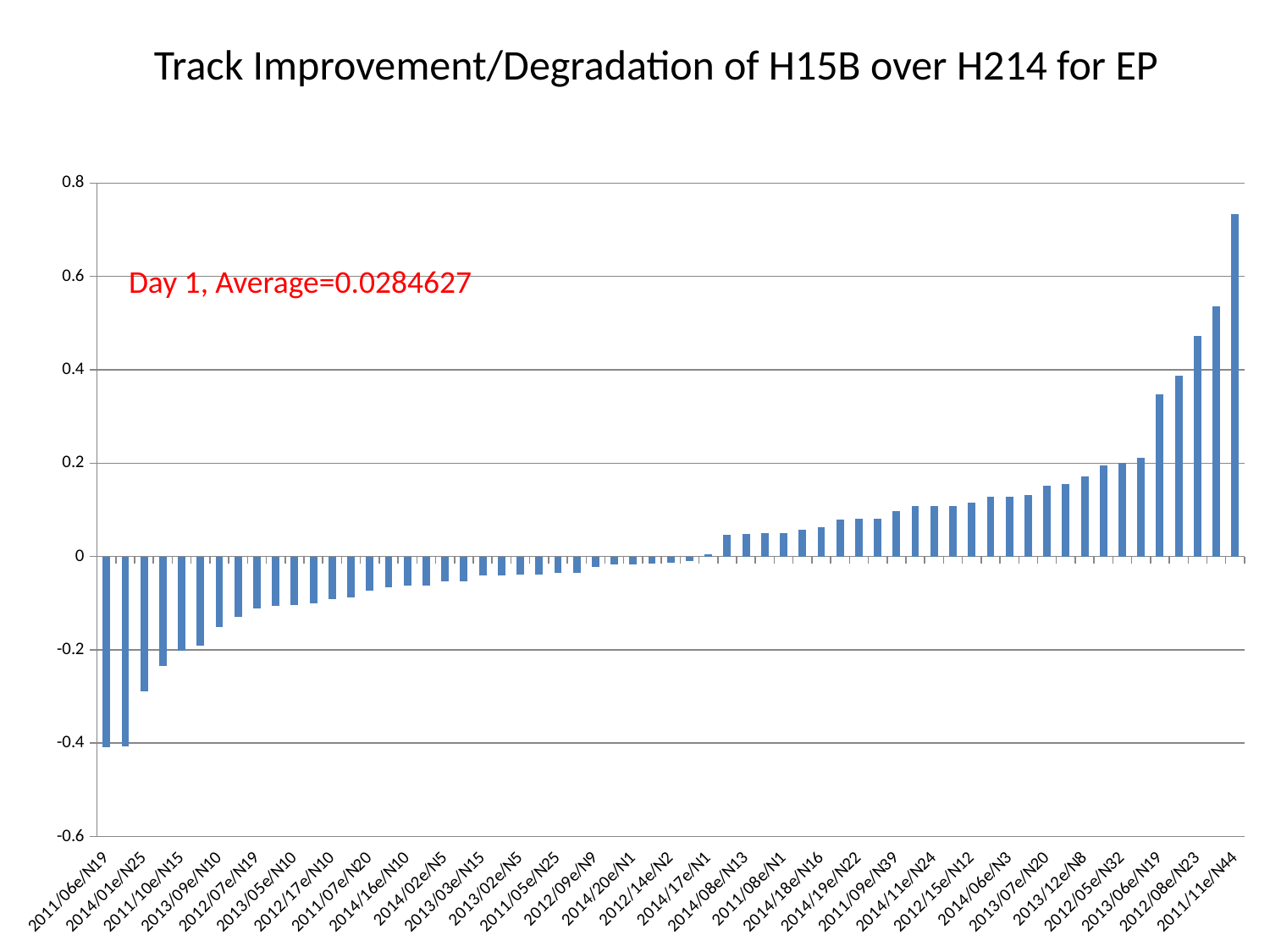
Is the value for 2012/08e/N23 greater or less than 0.4? greater Which category has the highest value? 2011/11e/N44 Is the value for 2013/06e/N19 greater or less than 0.4? less Which has the larger value, 2011/11e/N44 or 2012/08e/N23? 2011/11e/N44 What average value is stated in the red annotation on the chart? 0.0284627 Do the bar values rise or fall from left to right along the x axis? rise Is the value for 2011/06e/N19 greater or less than -0.2? less What kind of chart is shown on the slide? bar chart Which has the larger value, 2011/06e/N19 or 2014/01e/N25? 2014/01e/N25 What is the title of the chart? Track Improvement/Degradation of H15B over H214 for EP